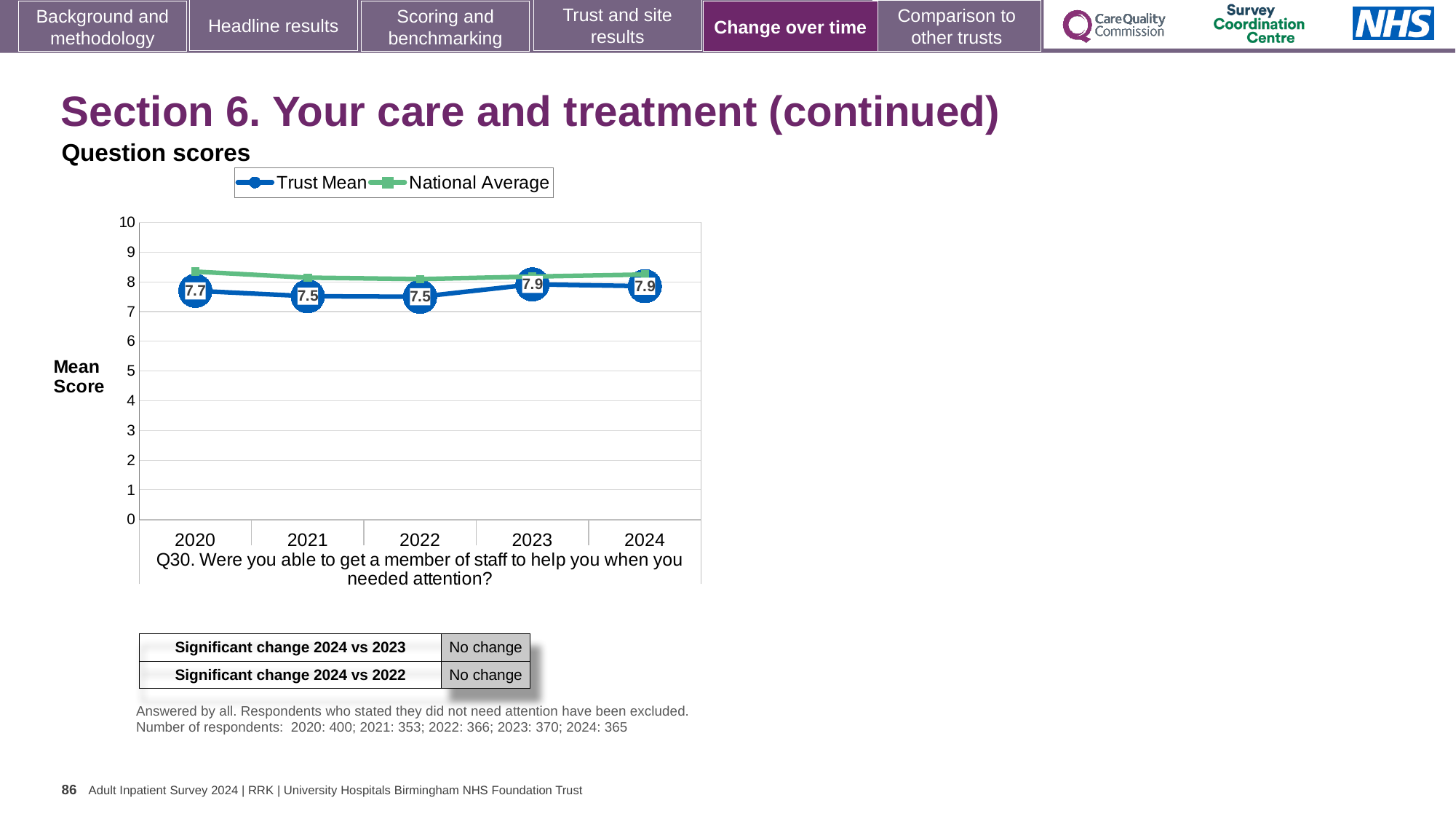
In 2020, which series has the higher value, Trust Mean or National Average? National Average What is the Trust Mean value for 2024? 7.9 How many years are plotted on the x axis? 5 Is the National Average value for 2020 greater or less than 8? greater What is the label on the y axis of the chart? Mean Score Which is larger, the Trust Mean for 2023 or the Trust Mean for 2022? 2023 What is the difference between the Trust Mean values for 2020 and 2021? 0.2 What is the Trust Mean value for 2020? 7.7 How many series does the legend list? 2 What is the Trust Mean value for 2022? 7.5 What is the difference between the Trust Mean values for 2023 and 2021? 0.4 What kind of chart is shown on the slide? Line chart